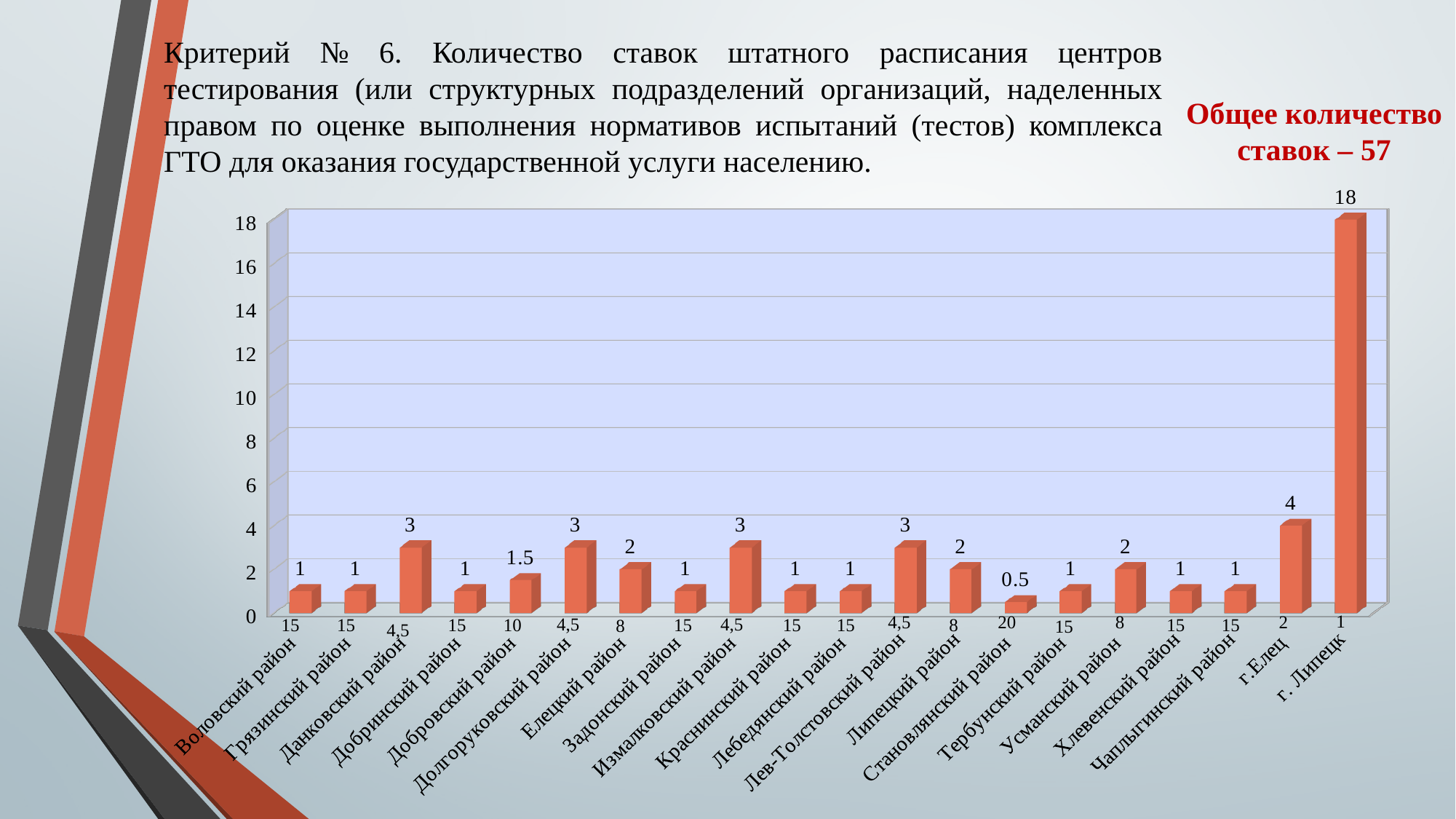
Which category has the highest value? г. Липецк What is the value for Лев-Толстовский район? 3 Is the value for г. Липецк greater or less than 16? greater How many categories are shown on the x axis of the chart? 20 What is the value for г.Елец? 4 What is the value for Добровский район? 1.5 What is the difference between the values for г. Липецк and г.Елец? 14 Which is larger, the value for Данковский район or the value for Елецкий район? Данковский район What is the value for г. Липецк? 18 What is the value for Становлянский район? 0.5 Which category has the lowest value? Становлянский район What kind of chart is shown on the slide? bar chart